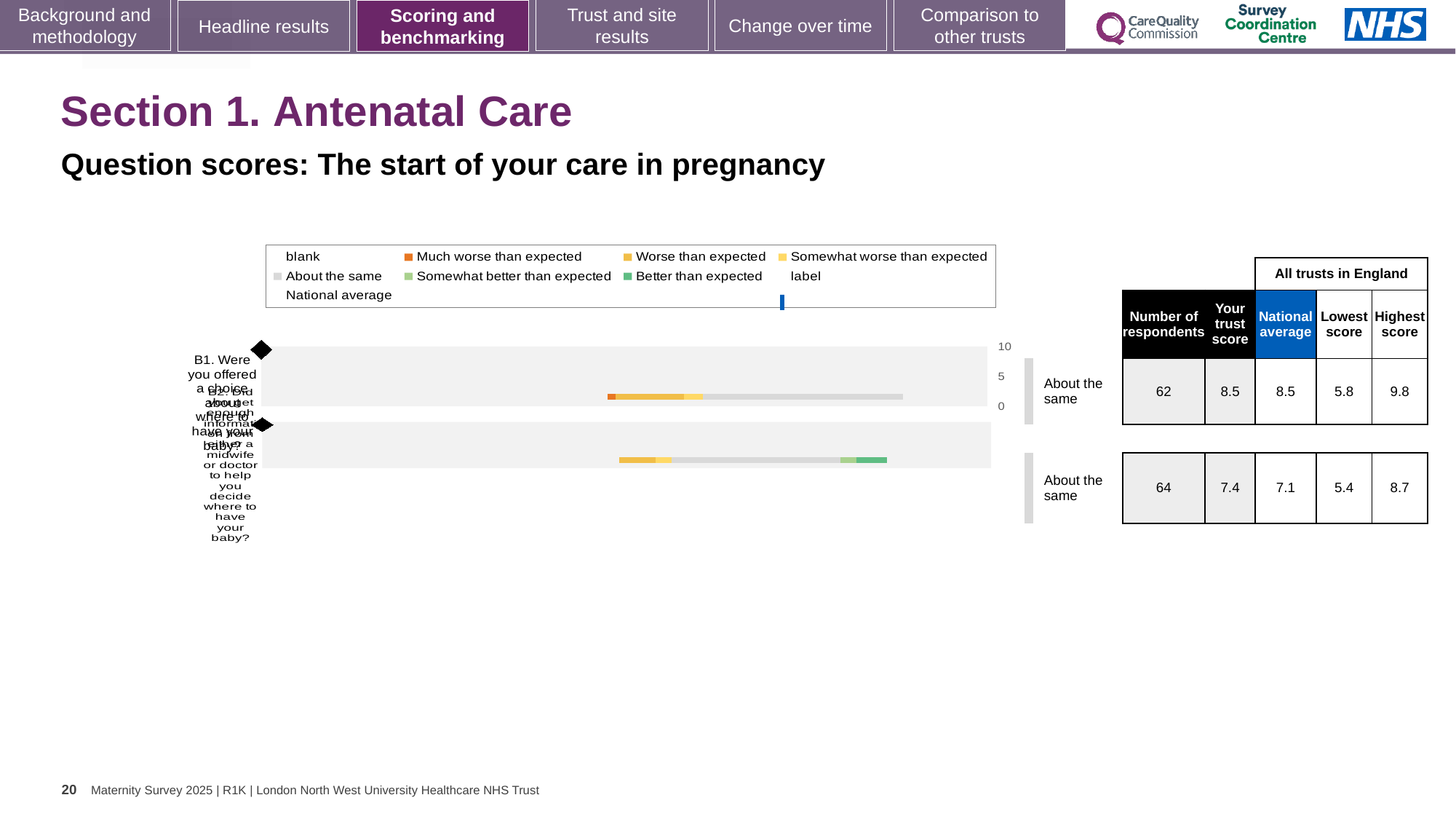
What type of chart is used to show the question scores on this slide? bar chart What is the maximum value shown on the chart's score axis? 10 How many questions (bars) are plotted in the chart? 2 What is the difference between the highest and lowest scores for question B1? 4.0 What is the highest score among all trusts in England for question B1? 9.8 Which question has the higher trust score, B1 or B2? B1 How many respondents answered question B1? 62 What is the national average score for question B2? 7.1 What is the 'Your trust score' for question B1 (Were you offered a choice about where to have your baby?)? 8.5 What is the lowest score among all trusts in England for question B2? 5.4 What benchmark category is shown for question B1? About the same By how much does the trust score for question B2 exceed the national average for B2? 0.3